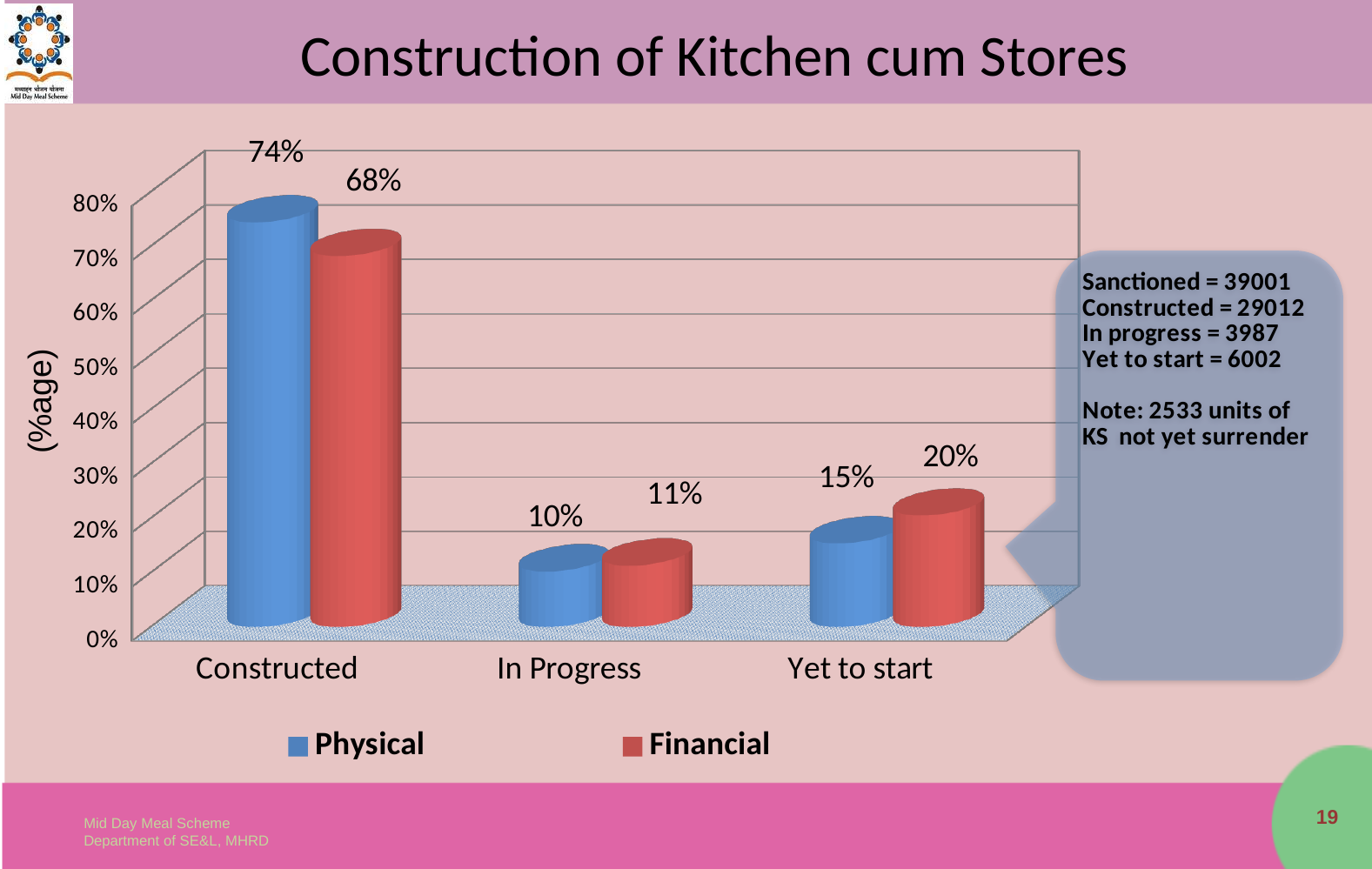
How many categories are shown on the x axis? 3 What is the Physical value for Constructed? 74% How many series does the legend list? 2 What is the Financial value for Yet to start? 20% For Yet to start, which series has the larger value, Physical or Financial? Financial What kind of chart is shown on the slide? Bar chart What is the Physical value for In Progress? 10% What is the difference between the Physical and Financial values for Constructed? 6% What is the Financial value for Constructed? 68% Which category has the lowest Financial value? In Progress Which category has the highest Physical value? Constructed What is the title of the chart? Construction of Kitchen cum Stores